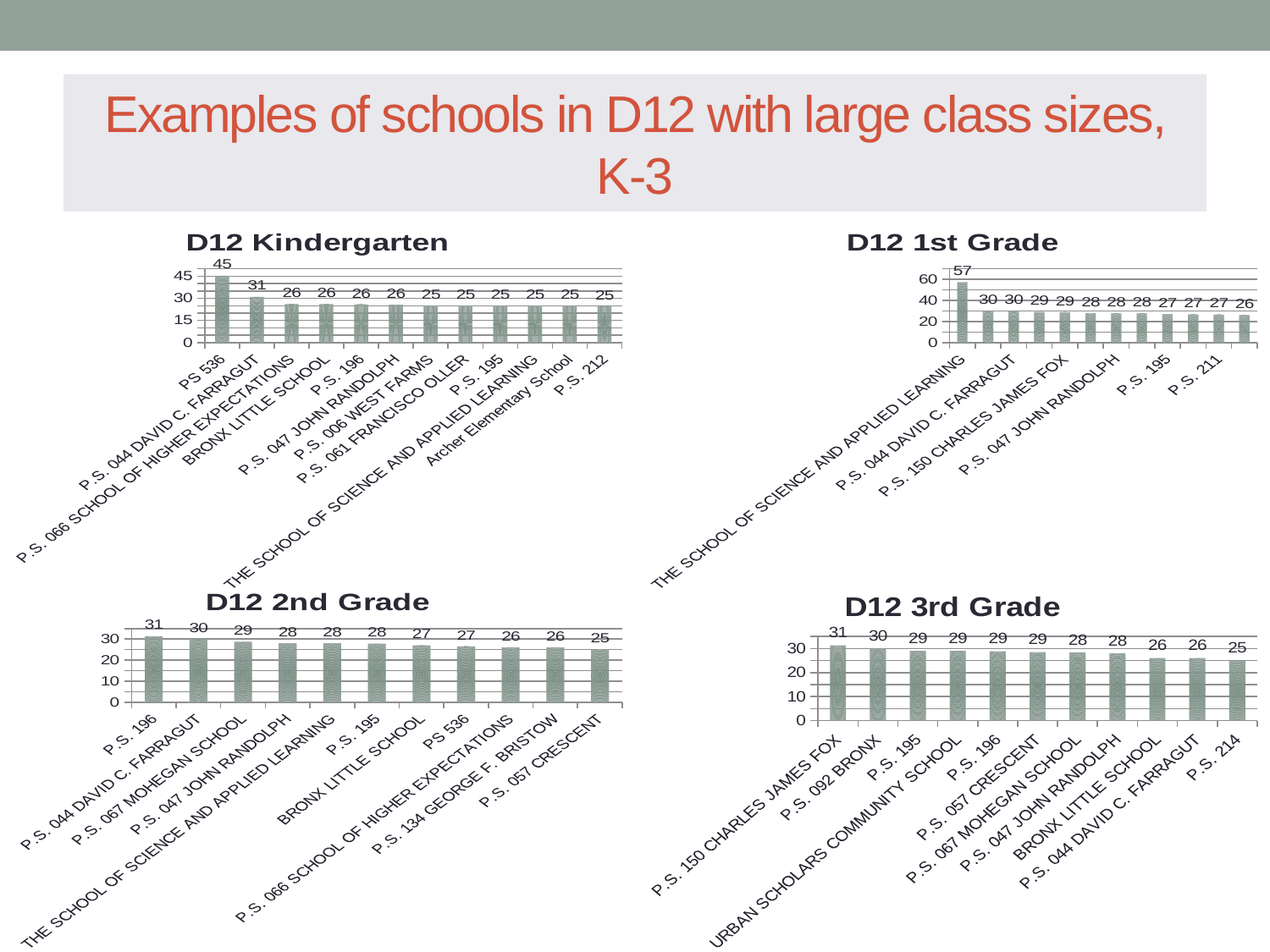
In the D12 1st Grade chart, which school has the highest value? THE SCHOOL OF SCIENCE AND APPLIED LEARNING What kind of chart is the D12 3rd Grade chart? Bar chart In the D12 2nd Grade chart, what is the value for P.S. 196? 31 In the D12 Kindergarten chart, what is the value for PS 536? 45 In the D12 Kindergarten chart, how many schools are plotted? 12 In the D12 Kindergarten chart, what is the difference between PS 536 and P.S. 044 DAVID C. FARRAGUT? 14 In the D12 2nd Grade chart, which school has the lowest value? P.S. 057 CRESCENT In the D12 Kindergarten chart, what is the value for P.S. 044 DAVID C. FARRAGUT? 31 In the D12 3rd Grade chart, which is larger, the value for P.S. 150 CHARLES JAMES FOX or the value for P.S. 214? P.S. 150 CHARLES JAMES FOX In the D12 2nd Grade chart, how many schools are plotted? 11 In the D12 3rd Grade chart, what is the value for P.S. 092 BRONX? 30 In the D12 1st Grade chart, what is the value for THE SCHOOL OF SCIENCE AND APPLIED LEARNING? 57